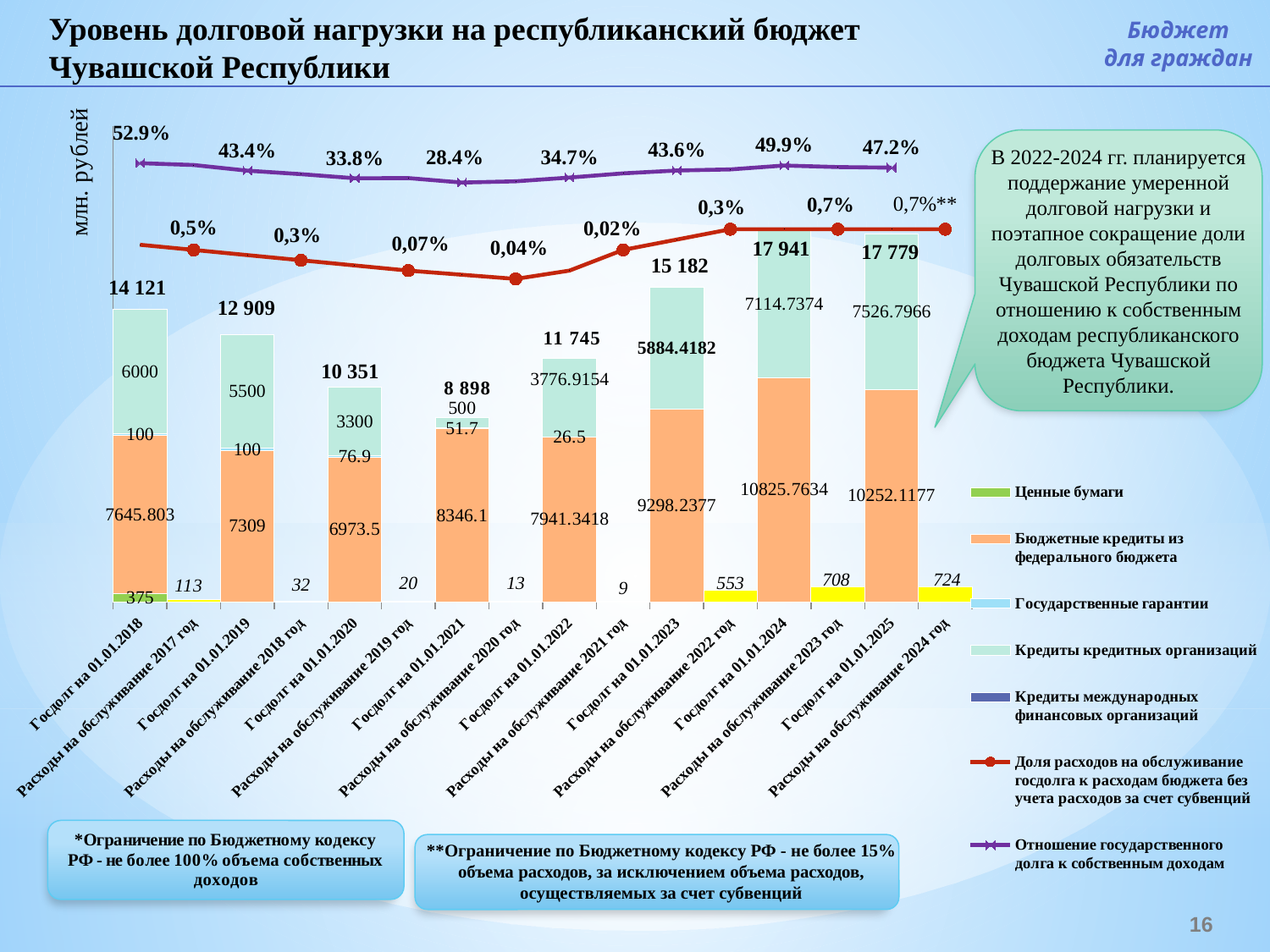
Which is larger: 'Кредиты кредитных организаций' for Госдолг на 01.01.2018 or for Госдолг на 01.01.2019? Госдолг на 01.01.2018 (6000) At which date does the 'Отношение государственного долга к собственным доходам' line reach its highest value? Госдолг на 01.01.2018 (52.9%) What is the value of 'Бюджетные кредиты из федерального бюджета' for Госдолг на 01.01.2025? 10252.1177 What is the value shown for 'Расходы на обслуживание 2024 год'? 724 How many series does the legend list? 7 At which date is the 'Отношение государственного долга к собственным доходам' line at its lowest? Госдолг на 01.01.2021 (28.4%) What is the difference between the total Госдолг на 01.01.2024 and Госдолг на 01.01.2025? 162 Which Госдолг bar has the highest total? Госдолг на 01.01.2024 (17 941) Which Госдолг bar has the lowest total? Госдолг на 01.01.2021 (8 898) What is the total state debt (Госдолг) shown for 01.01.2018? 14 121 What is the value of the 'Отношение государственного долга к собственным доходам' line for Госдолг на 01.01.2018? 52.9% What kind of chart is shown on the slide? Stacked bar chart with line series